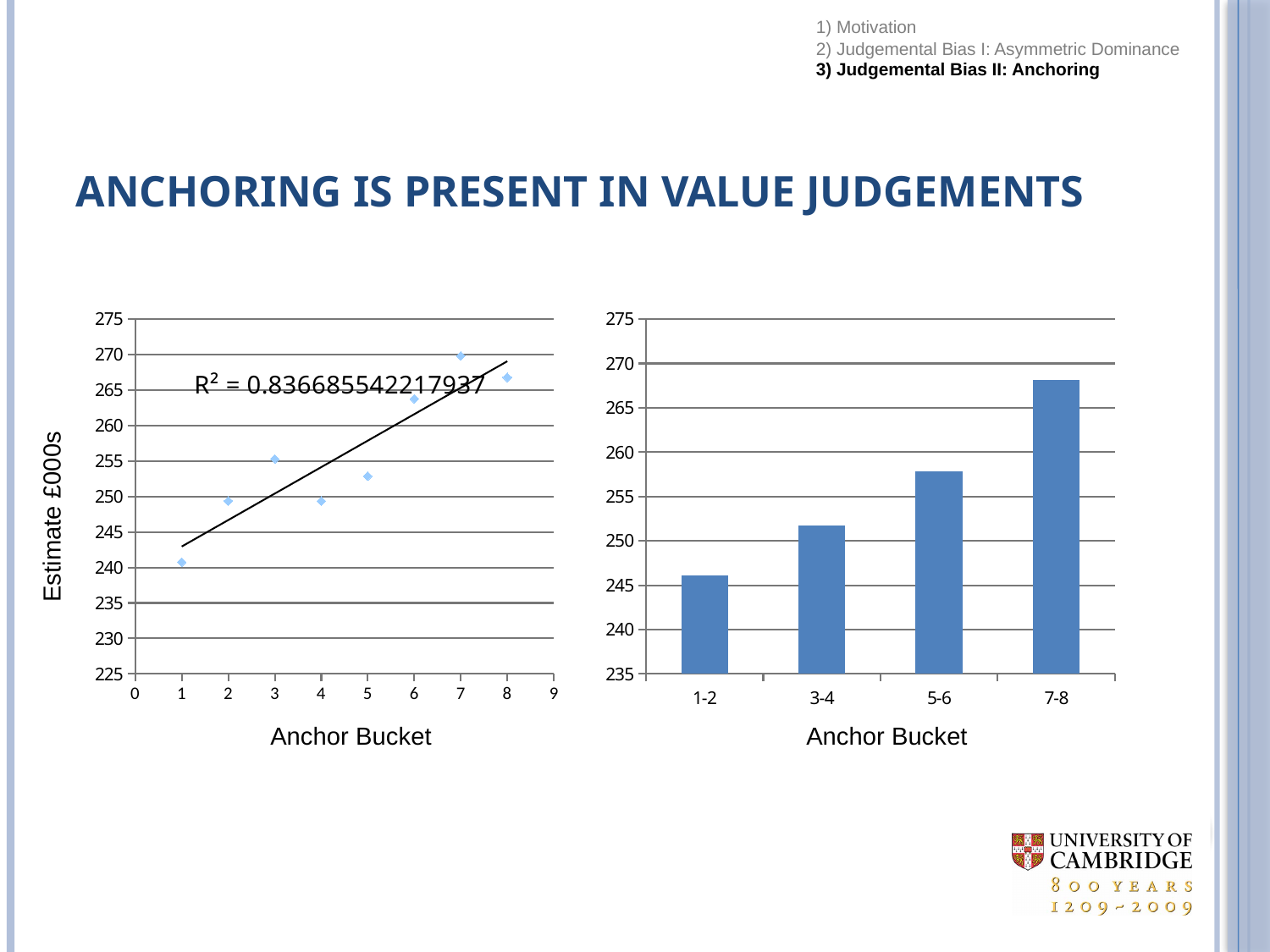
In the bar chart on the right, is the value for anchor bucket 7-8 greater or less than 265? greater In the bar chart on the right, how many anchor bucket categories are shown? 4 What kind of chart is the chart on the left of the slide? scatter chart In the scatter chart on the left, what R² value is printed next to the trendline? R² = 0.836685542217937 What kind of chart is the chart on the right of the slide? bar chart In the scatter chart on the left, is the value for anchor bucket 1 greater or less than 245? less In the bar chart on the right, is the value for anchor bucket 5-6 greater or less than 260? less In the scatter chart on the left, which anchor bucket has the lowest estimate? 1 In the bar chart on the right, do the values rise or fall as the anchor bucket increases from 1-2 to 7-8? rise In the bar chart on the right, which anchor bucket has the highest estimate? 7-8 In the bar chart on the right, which anchor bucket has the lowest estimate? 1-2